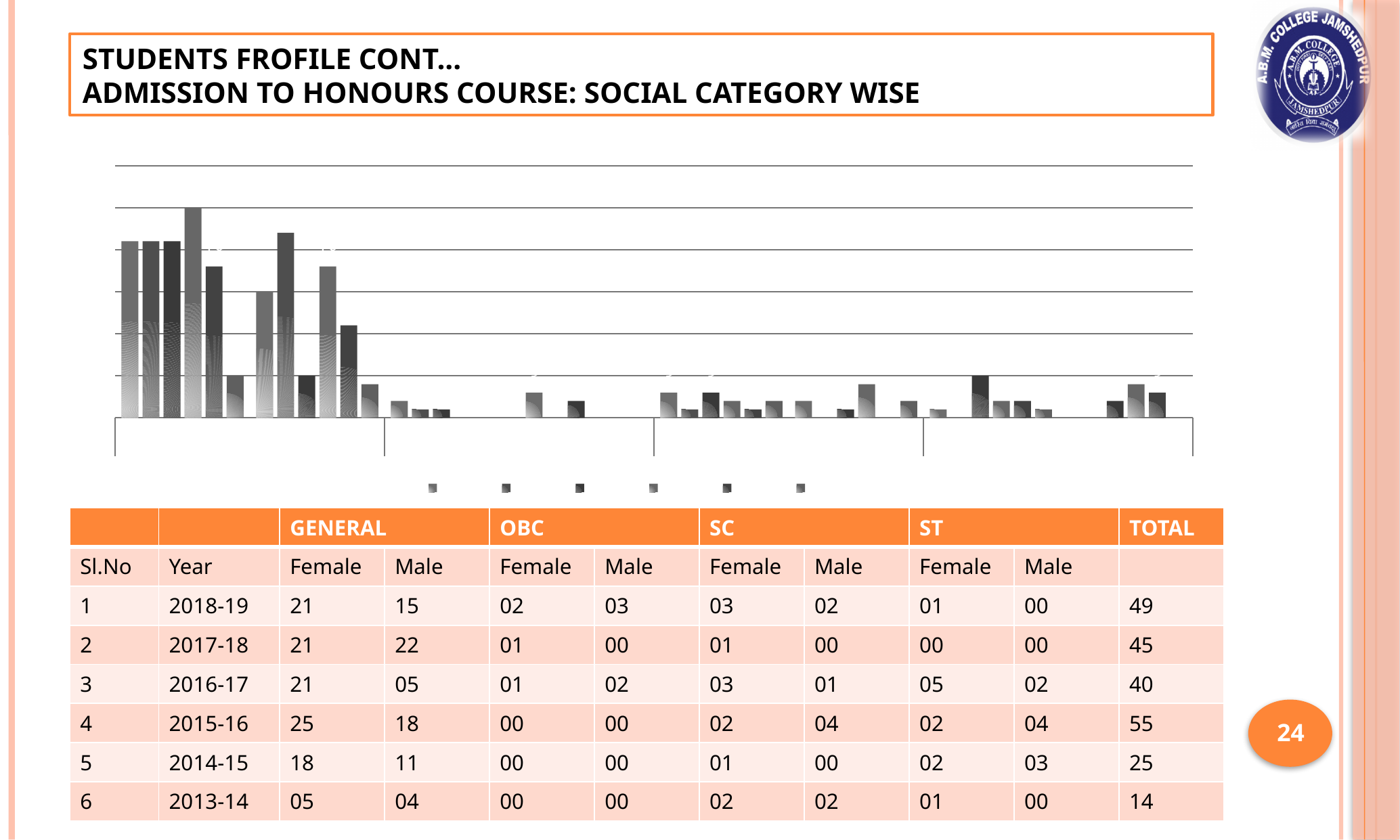
How many series does the chart's legend list? 6 What kind of chart is shown on the slide? bar chart How many category groups are separated along the x axis of the chart? 4 Are the bars in the chart vertical or horizontal? vertical Which category group on the chart, by position, contains the tallest bars? the leftmost group